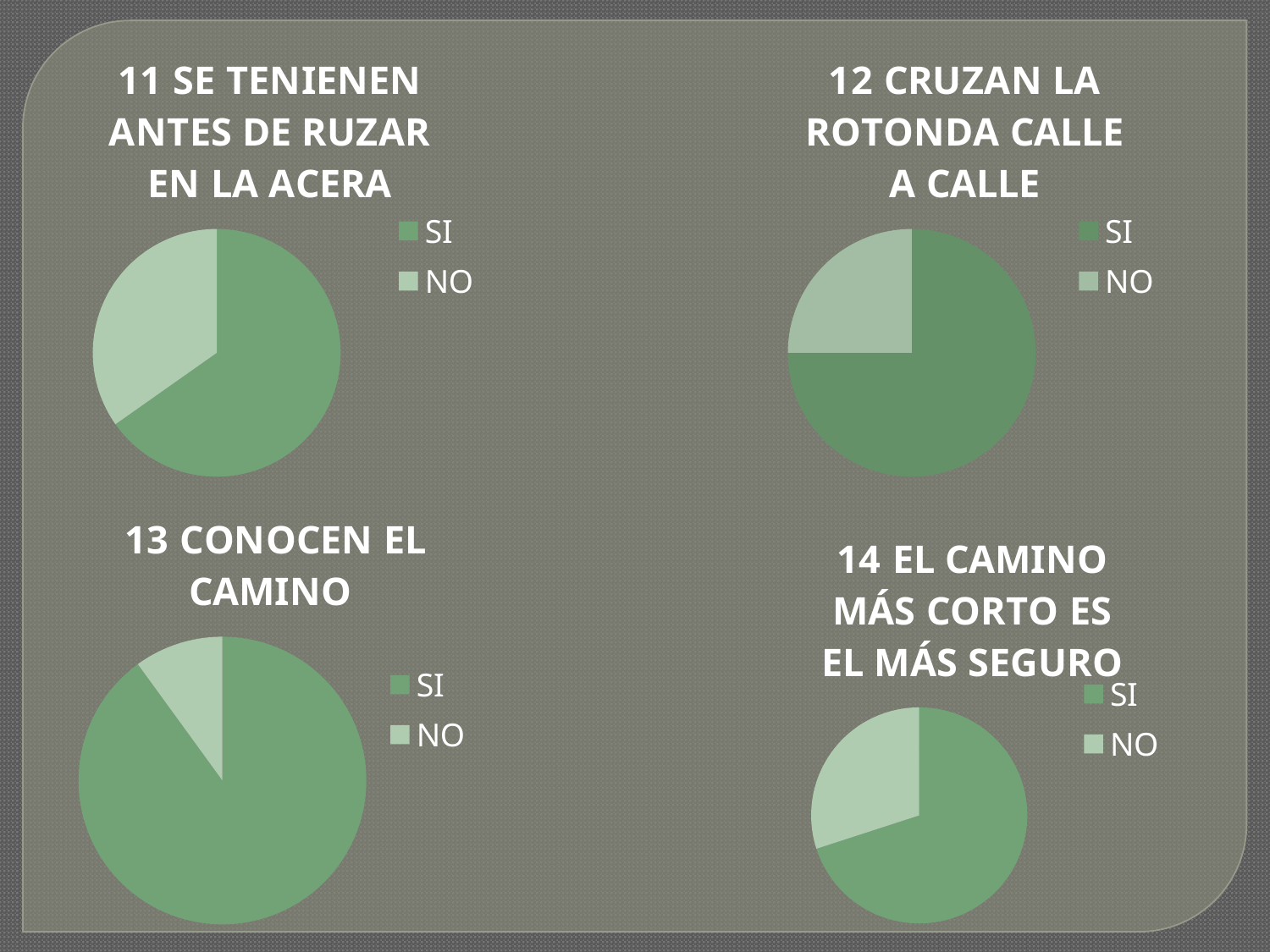
In the chart "12 CRUZAN LA ROTONDA CALLE A CALLE", which category has the smallest slice? NO In the chart "13 CONOCEN EL CAMINO", which category has the largest slice? SI In the chart "13 CONOCEN EL CAMINO", which category has the smallest slice? NO What are the two legend entries of the chart "14 EL CAMINO MÁS CORTO ES EL MÁS SEGURO"? SI and NO What kind of chart is used for "11 SE TENIENEN ANTES DE RUZAR EN LA ACERA"? pie chart In the chart "11 SE TENIENEN ANTES DE RUZAR EN LA ACERA", which category has the larger slice, SI or NO? SI How many categories does the legend of the chart "13 CONOCEN EL CAMINO" list? 2 In the chart "14 EL CAMINO MÁS CORTO ES EL MÁS SEGURO", which slice is larger, SI or NO? SI How many slices does the pie chart "12 CRUZAN LA ROTONDA CALLE A CALLE" have? 2 What is the title of the chart in the bottom-left of the slide? 13 CONOCEN EL CAMINO How many pie charts are shown on the slide? 4